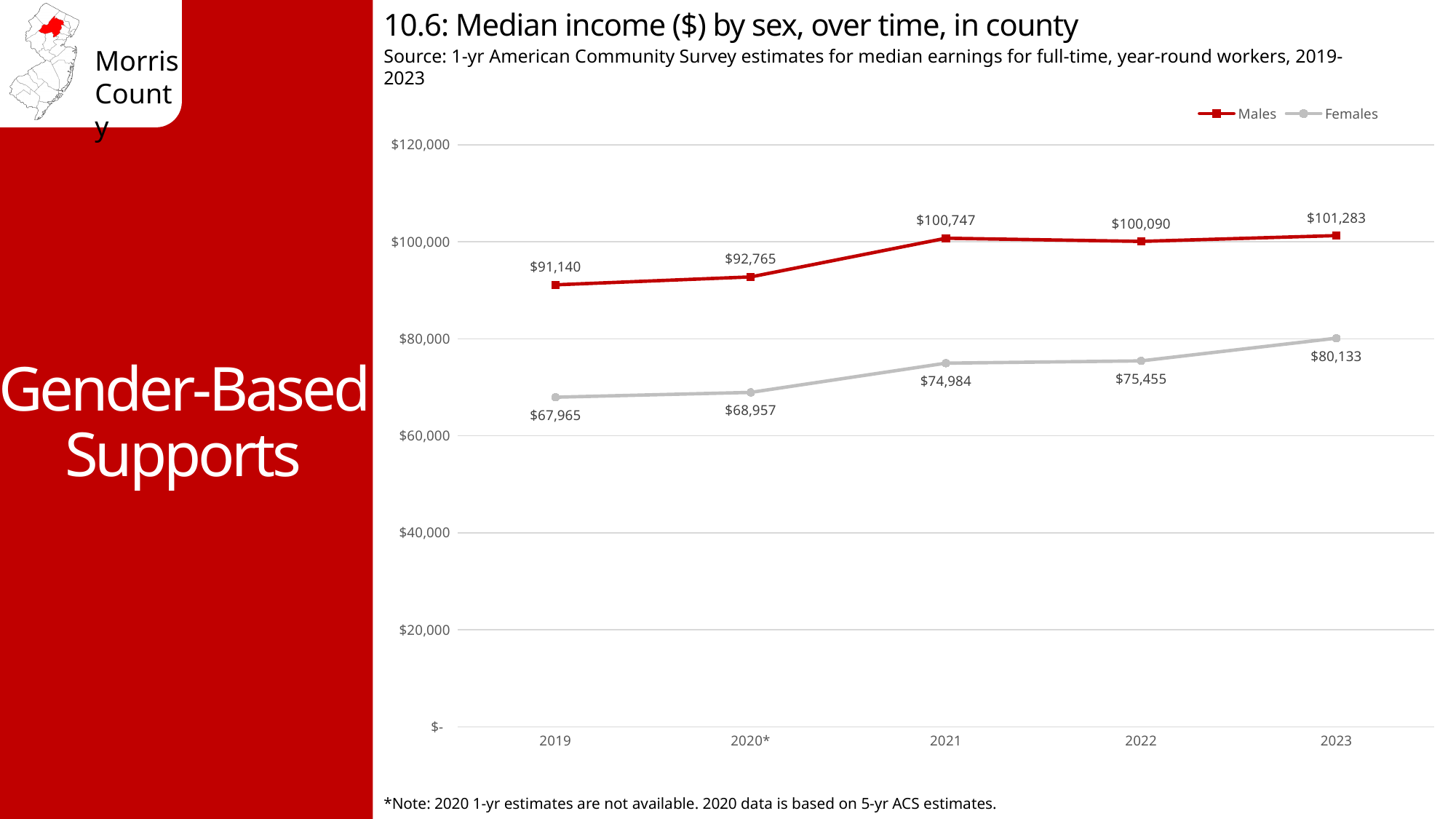
In which year was the median income for females lowest? 2019 What kind of chart is shown? line chart How many years are shown on the x axis? 5 Which was higher for males: median income in 2021 or 2022? 2021 What was the median income for males in 2019? $91,140 Is the median income for females in 2022 greater or less than $80,000? less What was the median income for females in 2021? $74,984 In which year was the median income for males highest? 2023 How many series does the legend list? 2 What was the median income for females in 2023? $80,133 What is the difference between male and female median income in 2023? $21,150 Does the median income for females rise or fall from 2019 to 2023? rise